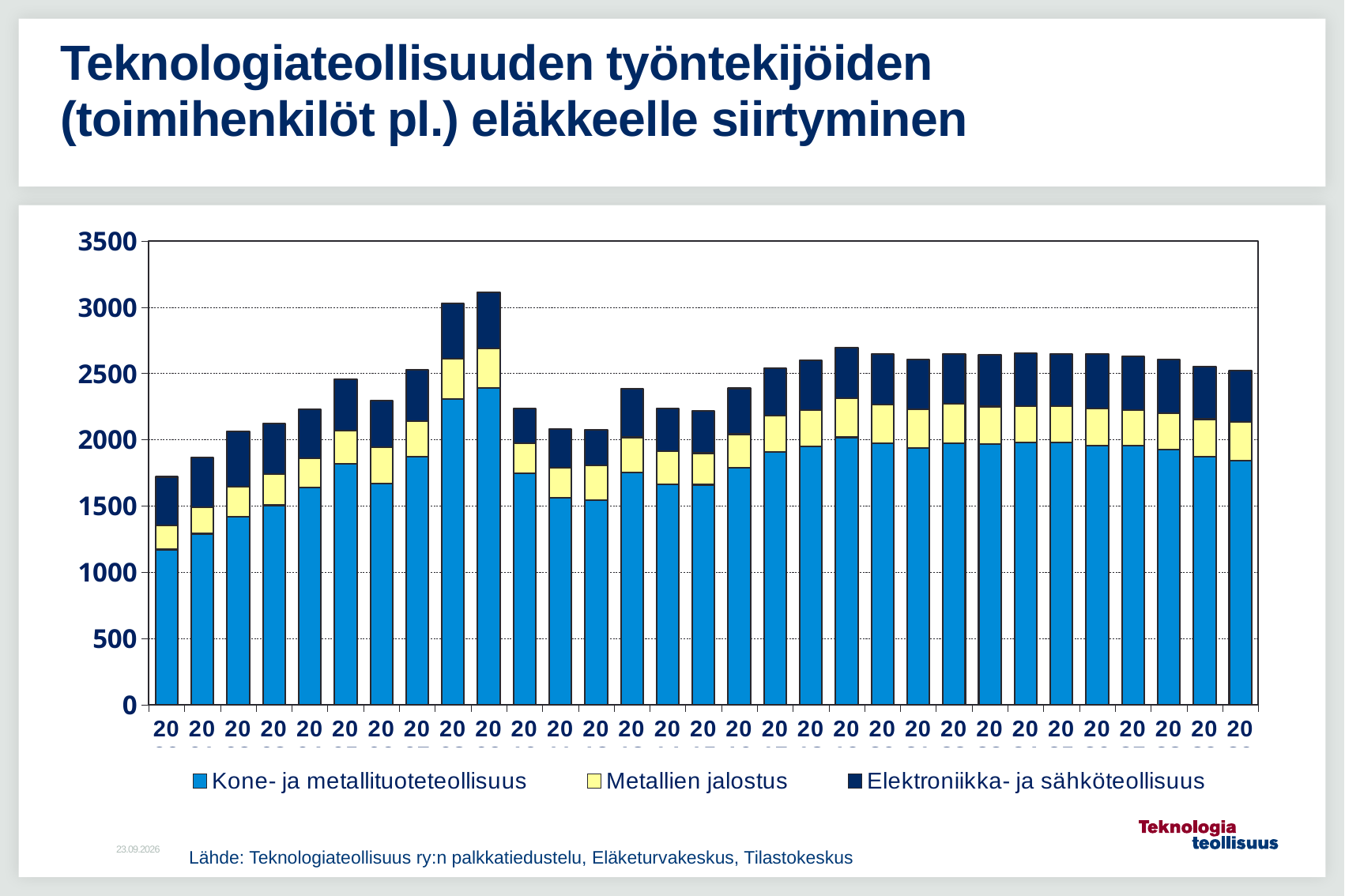
How many bars are plotted in the chart? 31 How many series does the legend list? 3 Is the total of the last (rightmost) bar greater or less than 2000? greater Which bar is the tallest: the ninth bar or the tenth bar from the left? the tenth bar Which series is shown in yellow in the legend? Metallien jalostus Is the total of the tallest bar greater or less than 3000? greater Is the total of the first (leftmost) bar greater or less than 2000? less Which bar has the lowest total in the chart? the first (leftmost) bar Do the bar totals rise or fall from the first bar to the sixth bar? rise Which series is shown in dark navy blue in the legend? Elektroniikka- ja sähköteollisuus What is the highest value shown on the y axis? 3500 What kind of chart is shown on the slide? stacked bar chart